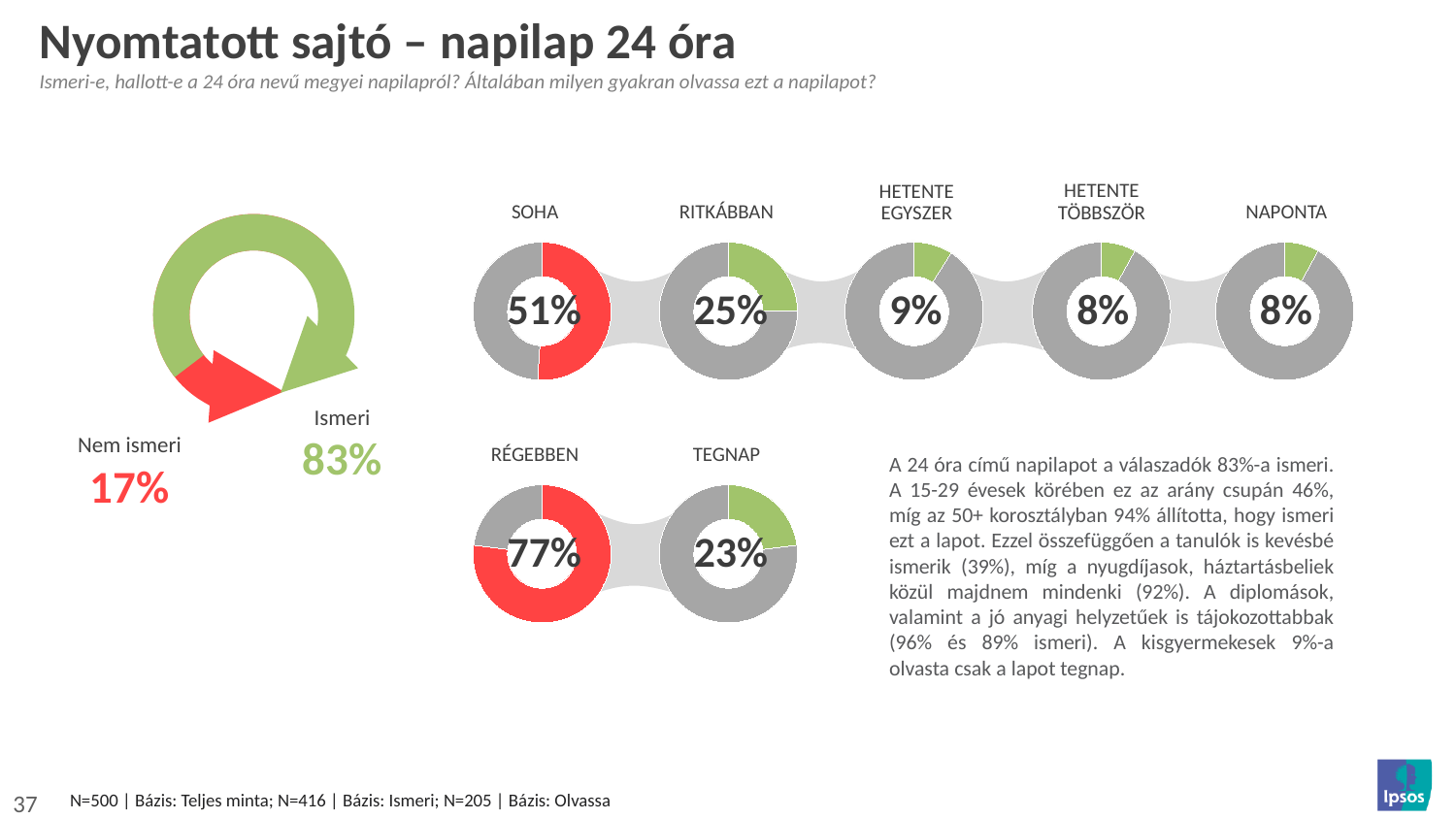
In the large donut chart on the left, what share of respondents is labelled "Ismeri"? 83% In the row of five donut charts at the top, how many reading-frequency categories are shown? 5 In the row of five donut charts at the top, which is larger: the value for "RITKÁBBAN" or the value for "NAPONTA"? RITKÁBBAN In the pair of donut charts at the bottom, what is the value for "RÉGEBBEN"? 77% In the row of five donut charts at the top, what is the value for "HETENTE EGYSZER"? 9% In the row of five donut charts at the top, what is the value for "RITKÁBBAN"? 25% In the large donut chart on the left, what share of respondents is labelled "Nem ismeri"? 17% In the row of five donut charts at the top, which category has the highest value? SOHA In the pair of donut charts at the bottom, what is the value for "TEGNAP"? 23% In the large donut chart on the left, what is the difference between the "Ismeri" and "Nem ismeri" shares? 66 percentage points In the row of five donut charts at the top, what is the value for "SOHA"? 51% In the row of five donut charts at the top, what is the difference between the "SOHA" and "RITKÁBBAN" values? 26 percentage points